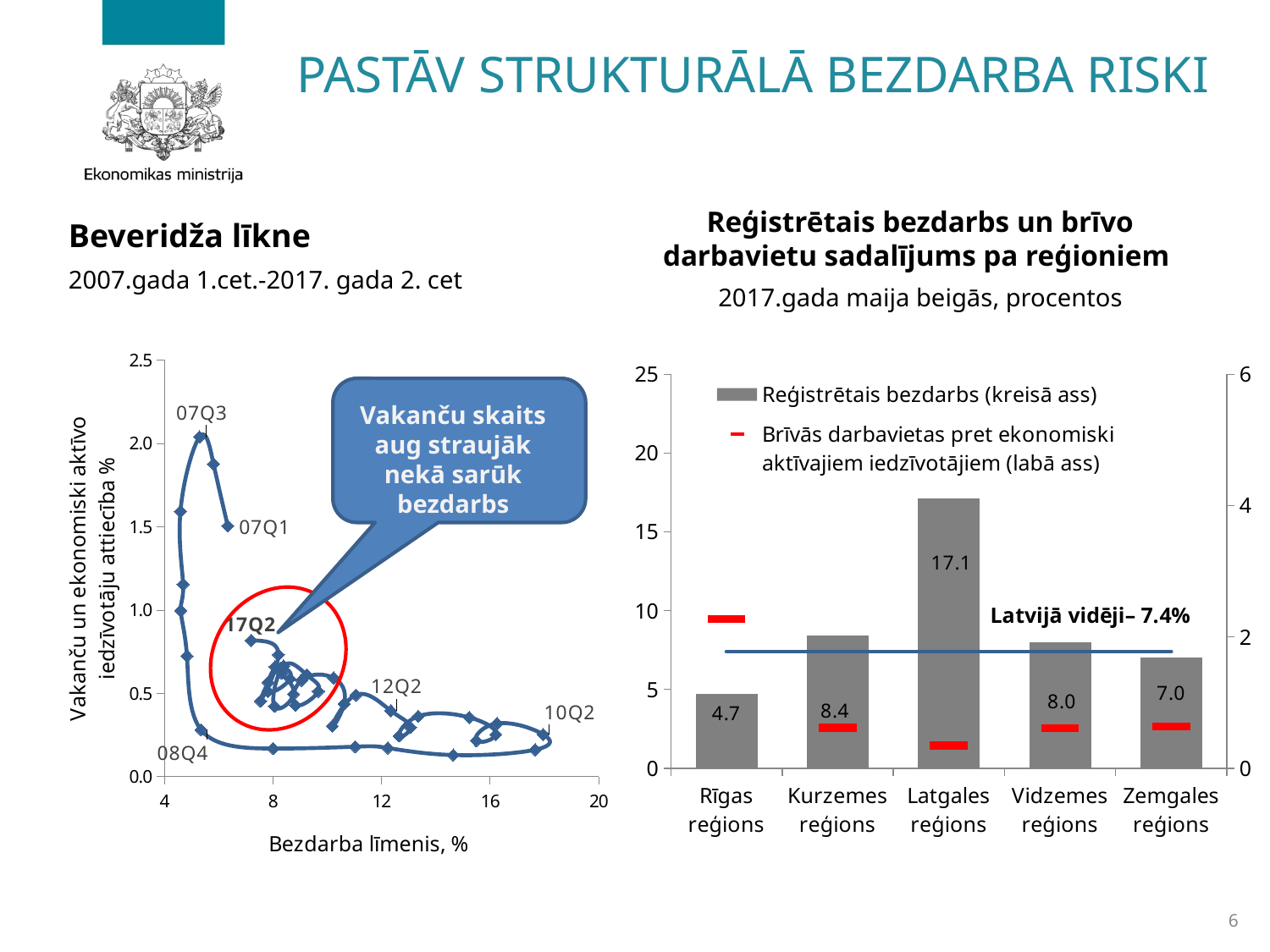
In the chart 'Reģistrētais bezdarbs un brīvo darbavietu sadalījums pa reģioniem', which region has the lowest registered unemployment? Rīgas reģions In the chart 'Reģistrētais bezdarbs un brīvo darbavietu sadalījums pa reģioniem', what is the registered unemployment value for Latgales reģions? 17.1 In the chart 'Reģistrētais bezdarbs un brīvo darbavietu sadalījums pa reģioniem', which region has the highest registered unemployment? Latgales reģions In the 'Beveridža līkne' chart, is the unemployment rate (x axis) at point 10Q2 greater or less than 16? greater What is the x-axis label of the 'Beveridža līkne' chart? Bezdarba līmenis, % In the chart 'Reģistrētais bezdarbs un brīvo darbavietu sadalījums pa reģioniem', what is the registered unemployment value for Rīgas reģions? 4.7 In the chart 'Reģistrētais bezdarbs un brīvo darbavietu sadalījums pa reģioniem', which has higher registered unemployment, Kurzemes reģions or Vidzemes reģions? Kurzemes reģions How many series does the legend of the chart 'Reģistrētais bezdarbs un brīvo darbavietu sadalījums pa reģioniem' list? 2 How many regions are shown in the chart 'Reģistrētais bezdarbs un brīvo darbavietu sadalījums pa reģioniem'? 5 In the chart 'Reģistrētais bezdarbs un brīvo darbavietu sadalījums pa reģioniem', what is the Latvian average registered unemployment shown on the chart? 7.4% In the chart 'Reģistrētais bezdarbs un brīvo darbavietu sadalījums pa reģioniem', is the vacancy ratio (right axis) for Rīgas reģions greater or less than 2? greater In the chart 'Reģistrētais bezdarbs un brīvo darbavietu sadalījums pa reģioniem', what is the difference in registered unemployment between Latgales reģions and Zemgales reģions? 10.1